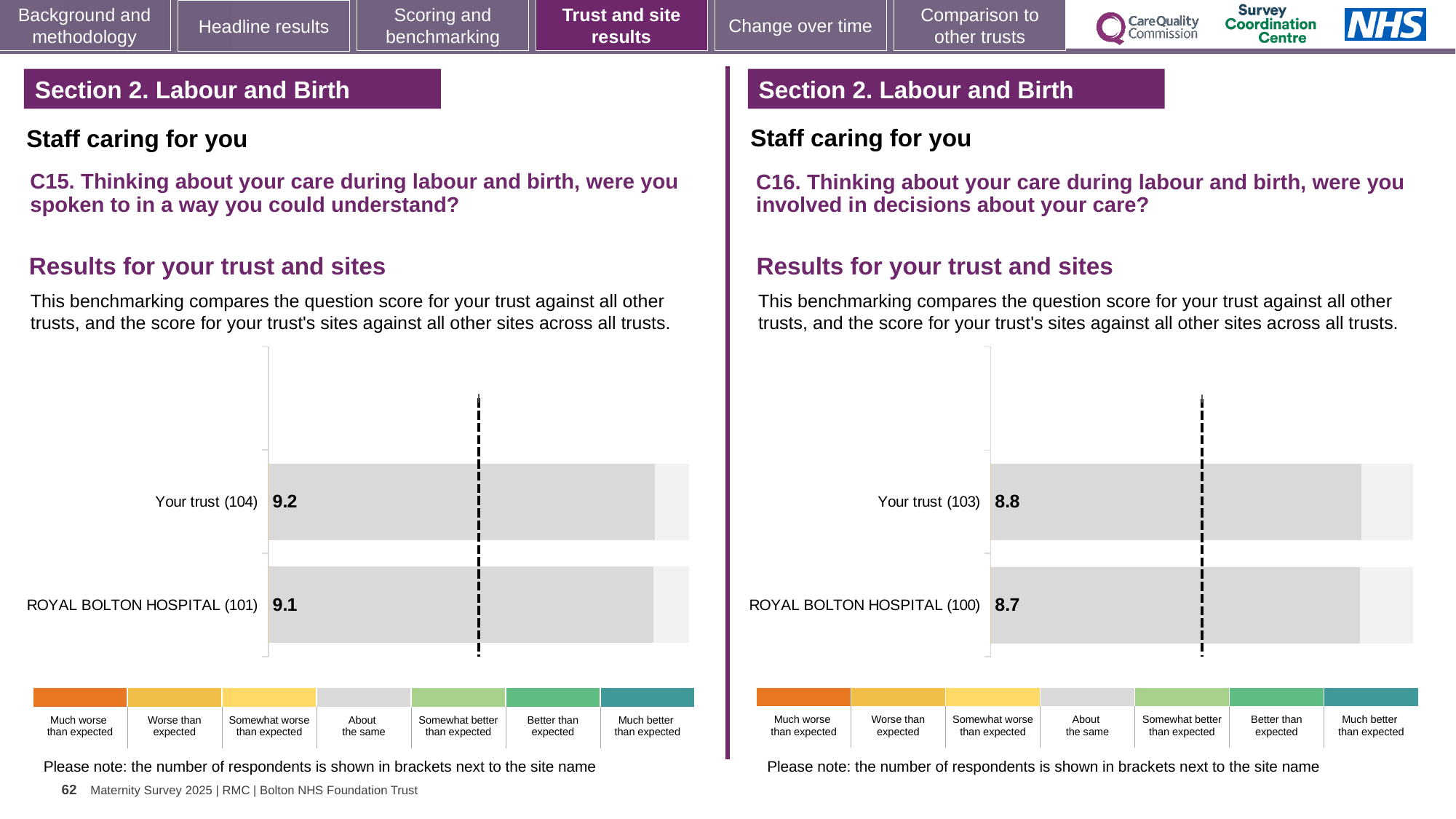
In the C15 chart on the left, which has the higher score, Your trust or ROYAL BOLTON HOSPITAL? Your trust In the C15 chart on the left, what is the difference between the score for Your trust and the score for ROYAL BOLTON HOSPITAL? 0.1 According to the colour key below the C15 chart on the left, which category does the grey bar colour represent? About the same In the C16 chart on the right, which has the lower score, Your trust or ROYAL BOLTON HOSPITAL? ROYAL BOLTON HOSPITAL In the C16 chart on the right, what is the difference between the score for Your trust and the score for ROYAL BOLTON HOSPITAL? 0.1 In the C15 chart on the left, what is the score for ROYAL BOLTON HOSPITAL (101)? 9.1 In the C16 chart on the right, what is the score for Your trust (103)? 8.8 In the C16 chart on the right, what is the score for ROYAL BOLTON HOSPITAL (100)? 8.7 What kind of chart is used for the C16 results on the right? Bar chart In the C15 chart on the left, what is the score for Your trust (104)? 9.2 How many bars are plotted in the C15 chart on the left? 2 How many respondents are shown in brackets for Your trust in the C16 chart on the right? 103